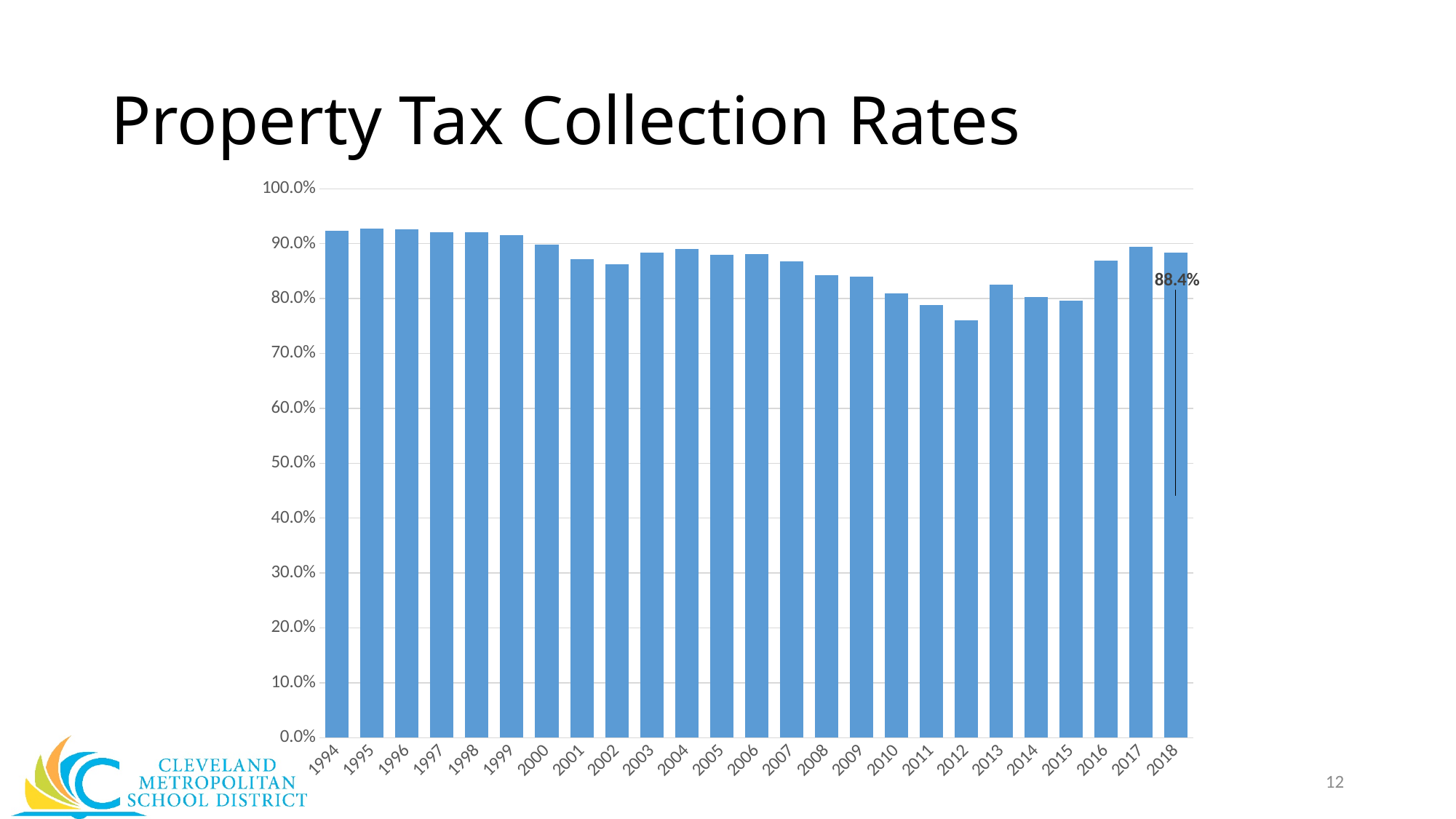
Which year has the higher collection rate, 1994 or 2010? 1994 What kind of chart is used to show the property tax collection rates? Bar chart Is the value for 1994 greater or less than 90.0%? greater Is the value for 2001 greater or less than 90.0%? less Which year has the higher collection rate, 2012 or 2016? 2016 Is the value for 2012 greater or less than 80.0%? less What is the title of the slide containing the chart? Property Tax Collection Rates How many years are shown on the x axis of the chart? 25 Which year has the lowest property tax collection rate? 2012 What is the property tax collection rate shown for 2018? 88.4%